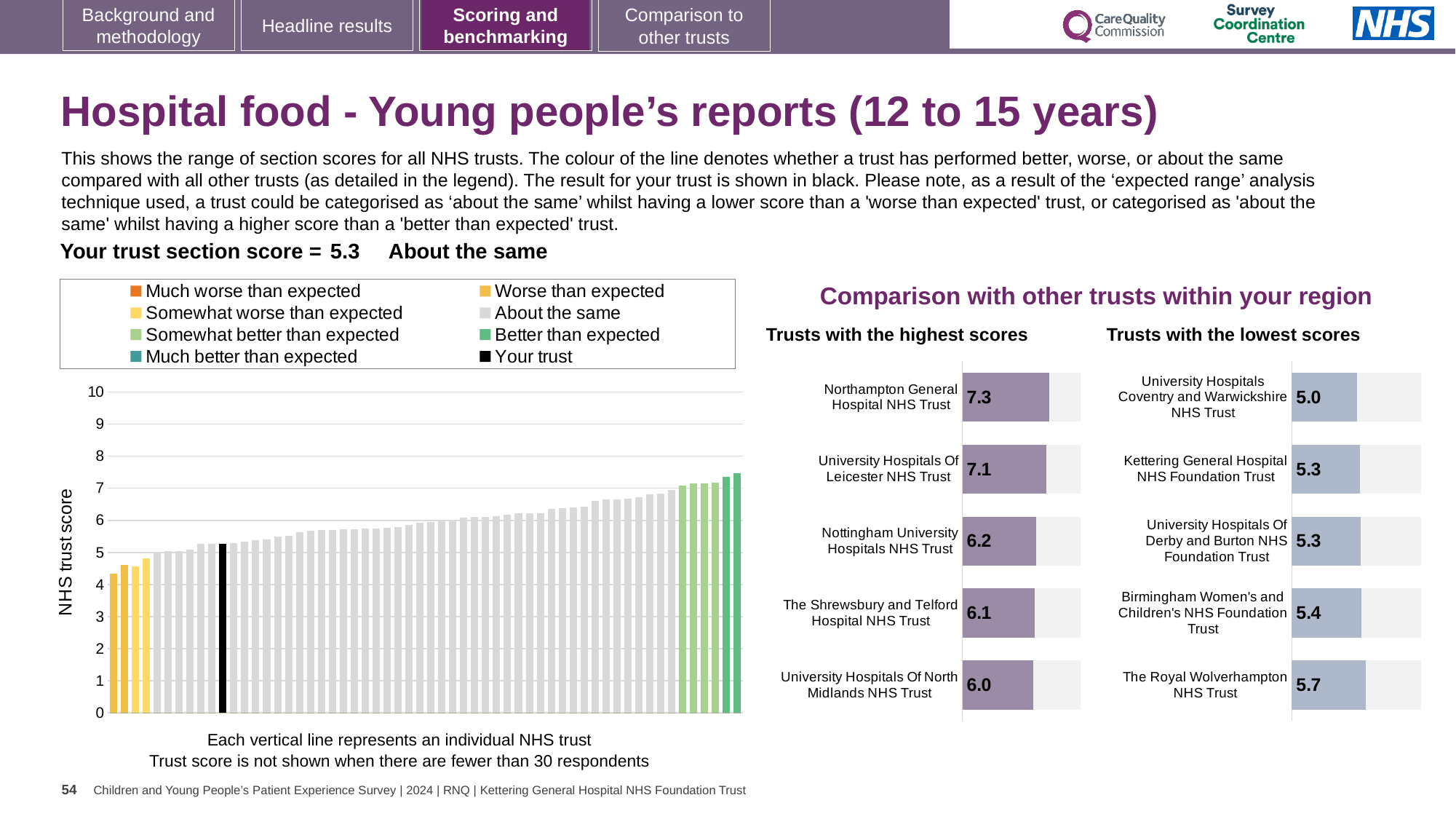
How many entries does the legend of the NHS trust score chart on the left list? 8 In the 'Trusts with the lowest scores' chart, which has the larger score: Birmingham Women's and Children's NHS Foundation Trust or Kettering General Hospital NHS Foundation Trust? Birmingham Women's and Children's NHS Foundation Trust In the NHS trust score chart on the left, is the value of the black 'Your trust' bar greater or less than 6? less In the 'Trusts with the highest scores' chart, what is the score for Nottingham University Hospitals NHS Trust? 6.2 In the NHS trust score chart on the left, is the value of the tallest bar greater or less than 7? greater In the 'Trusts with the lowest scores' chart, which trust has the lowest score? University Hospitals Coventry and Warwickshire NHS Trust In the 'Trusts with the highest scores' chart, which trust has the highest score? Northampton General Hospital NHS Trust In the 'Trusts with the highest scores' chart, what is the difference between the scores of Northampton General Hospital NHS Trust and University Hospitals Of North Midlands NHS Trust? 1.3 In the 'Trusts with the lowest scores' chart, what is the score for University Hospitals Coventry and Warwickshire NHS Trust? 5.0 How many trusts are listed in the 'Trusts with the lowest scores' chart? 5 In the 'Trusts with the lowest scores' chart, what is the score for The Royal Wolverhampton NHS Trust? 5.7 In the 'Trusts with the highest scores' chart, what is the score for Northampton General Hospital NHS Trust? 7.3